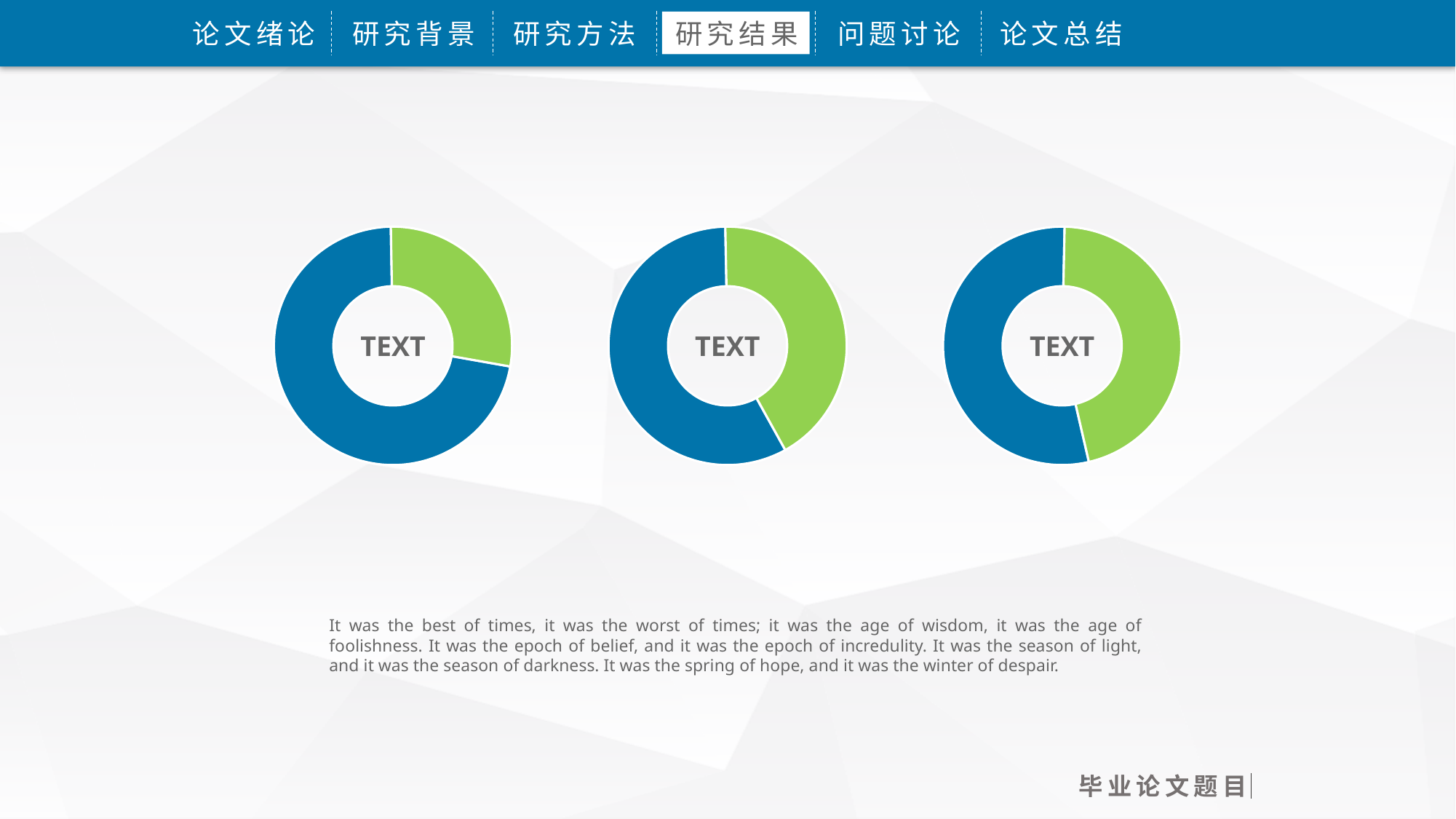
How many slices does the middle donut chart have? 2 In the right donut chart, which slice is larger, the blue one or the green one? Blue In the left donut chart, which slice is larger, the blue one or the green one? Blue How many slices does the left donut chart have? 2 How many donut charts are shown on the slide? 3 What kind of chart is the left chart on the slide? Donut chart In the middle donut chart, which slice is larger, the blue one or the green one? Blue What text is shown in the centre of each donut chart? TEXT What two colours are used for the slices in the donut charts? Blue and green